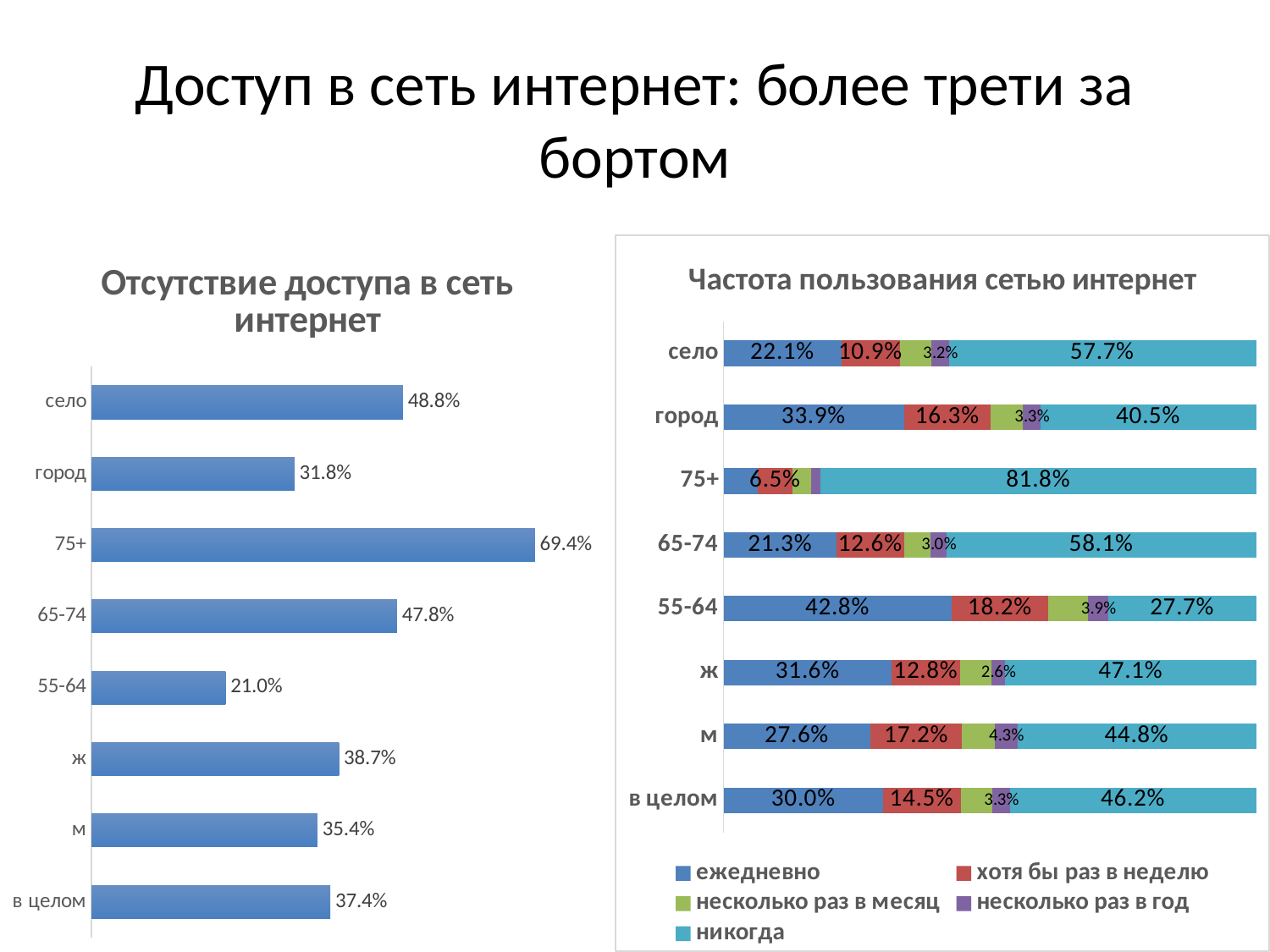
In the chart 'Частота пользования сетью интернет', what is the 'ежедневно' value for '55-64'? 42.8% In the chart 'Отсутствие доступа в сеть интернет', what is the difference between the values for 'село' and 'город'? 17.0 percentage points In the chart 'Отсутствие доступа в сеть интернет', which is larger, the value for 'ж' or the value for 'м'? ж In the chart 'Отсутствие доступа в сеть интернет', which category has the lowest value? 55-64 In the chart 'Частота пользования сетью интернет', what is the 'никогда' value for '75+'? 81.8% In the chart 'Частота пользования сетью интернет', what is the difference between the 'никогда' values for '75+' and '55-64'? 54.1 percentage points How many series does the legend of the chart 'Частота пользования сетью интернет' list? 5 How many categories are shown in the chart 'Отсутствие доступа в сеть интернет'? 8 In the chart 'Частота пользования сетью интернет', which category has the highest 'ежедневно' value? 55-64 What type of chart is 'Частота пользования сетью интернет'? Stacked bar chart In the chart 'Отсутствие доступа в сеть интернет', what is the value for 'село'? 48.8% In the chart 'Отсутствие доступа в сеть интернет', which category has the highest value? 75+